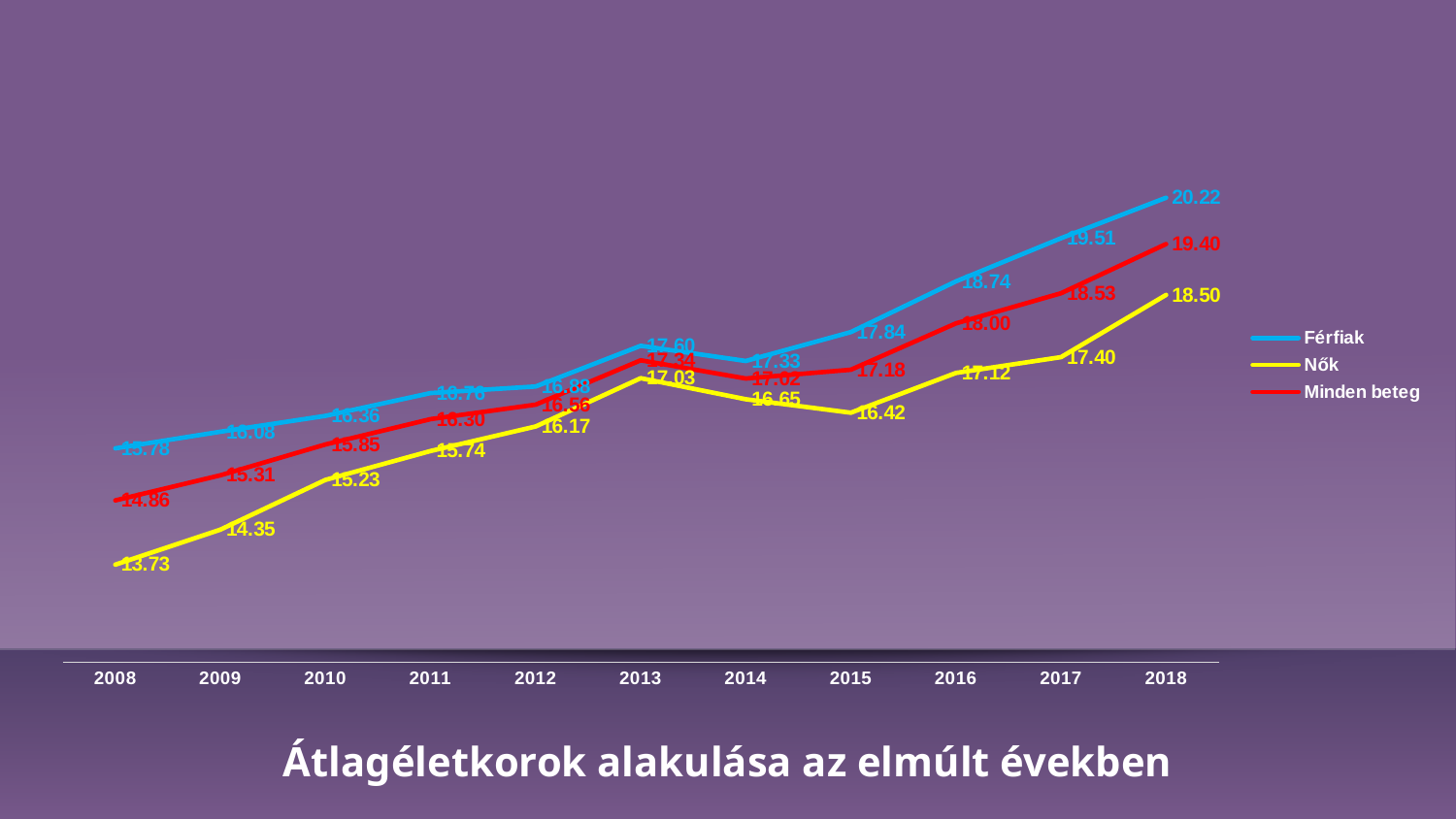
How many years are shown on the x axis? 11 In which year is the Nők series at its lowest? 2008 How many series does the legend list? 3 What is the value for Minden beteg in 2016? 18.00 Which is larger for Nők: the value in 2013 or the value in 2014? 2013 What is the value for Nők in 2008? 13.73 What kind of chart is shown on the slide? line chart Does the Férfiak series rise or fall from 2015 to 2018? rise In which year is the Férfiak series at its highest? 2018 What is the difference between the Férfiak and Nők values in 2018? 1.72 What is the value for Férfiak in 2018? 20.22 By how much did the Minden beteg value increase from 2008 to 2018? 4.54